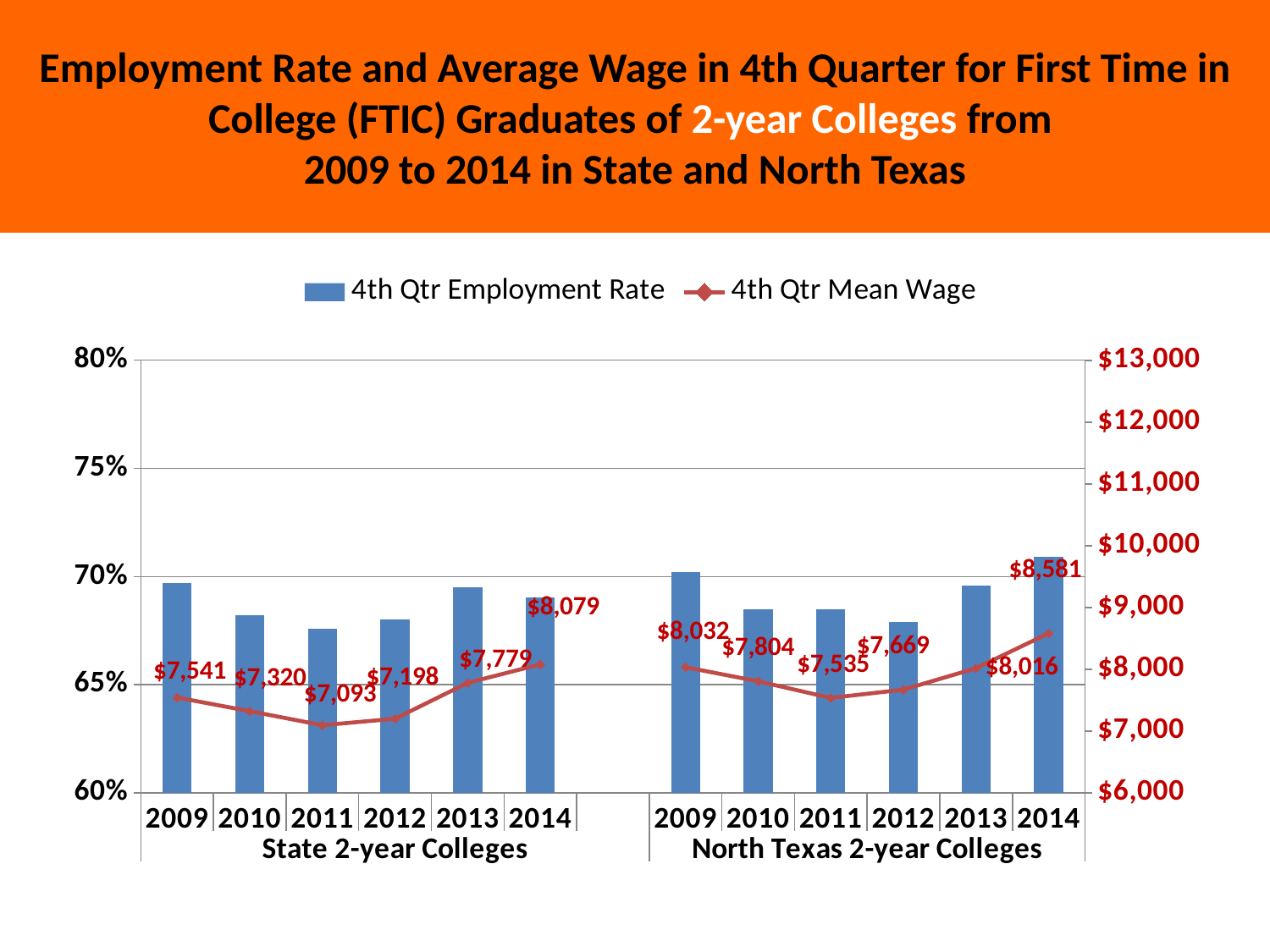
What was the 4th Qtr Mean Wage for North Texas 2-year Colleges graduates in 2009? $8,032 Which year had the lowest 4th Qtr Mean Wage for State 2-year Colleges graduates? 2011 Did the 4th Qtr Mean Wage for State 2-year Colleges rise or fall from 2011 to 2014? rise What is the difference between the 4th Qtr Mean Wage for North Texas 2-year Colleges and State 2-year Colleges in 2012? $471 Which was larger in 2010: the 4th Qtr Mean Wage for State 2-year Colleges or for North Texas 2-year Colleges? North Texas 2-year Colleges What is the difference between the 4th Qtr Mean Wage for State 2-year Colleges in 2014 and in 2013? $300 Is the 4th Qtr Employment Rate for State 2-year Colleges in 2011 greater or less than 65%? greater Which year had the highest 4th Qtr Mean Wage for North Texas 2-year Colleges graduates? 2014 How many series does the legend list? 2 What was the 4th Qtr Mean Wage for State 2-year Colleges graduates in 2011? $7,093 What was the 4th Qtr Mean Wage for North Texas 2-year Colleges graduates in 2014? $8,581